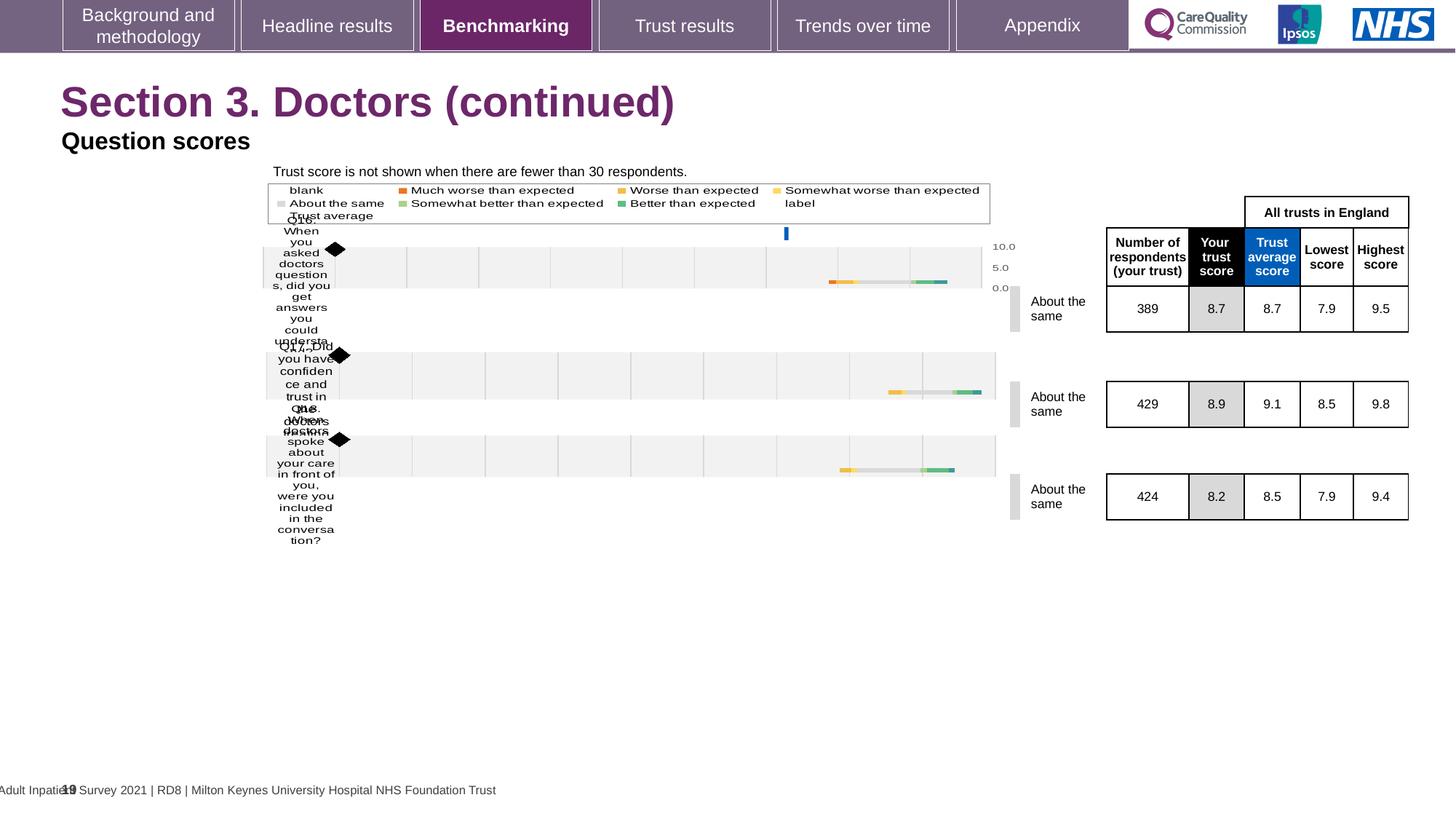
How many respondents from your trust answered Q17 (Did you have confidence and trust in the doctors treating you)? 429 Is the 'Your trust score' for Q17 greater or less than 5.0? greater Which question has the highest 'Your trust score' on this slide? Q17 For Q18, which is larger: the 'Your trust score' or the 'Trust average score'? Trust average score Which question has the lowest 'Your trust score' on this slide? Q18 What is the 'Your trust score' for Q16 (When you asked doctors questions, did you get answers you could understand)? 8.7 What is the difference between the 'Your trust score' for Q17 and for Q16? 0.2 What kind of chart is used to show the question scores on this slide? bar chart What is the highest score across all trusts in England for Q18 (When doctors spoke about your care in front of you, were you included in the conversation)? 9.4 How many questions (Q16, Q17, Q18) are charted on this slide? 3 What benchmarking category is shown next to each of the three question charts? About the same What is the lowest score across all trusts in England for Q16? 7.9